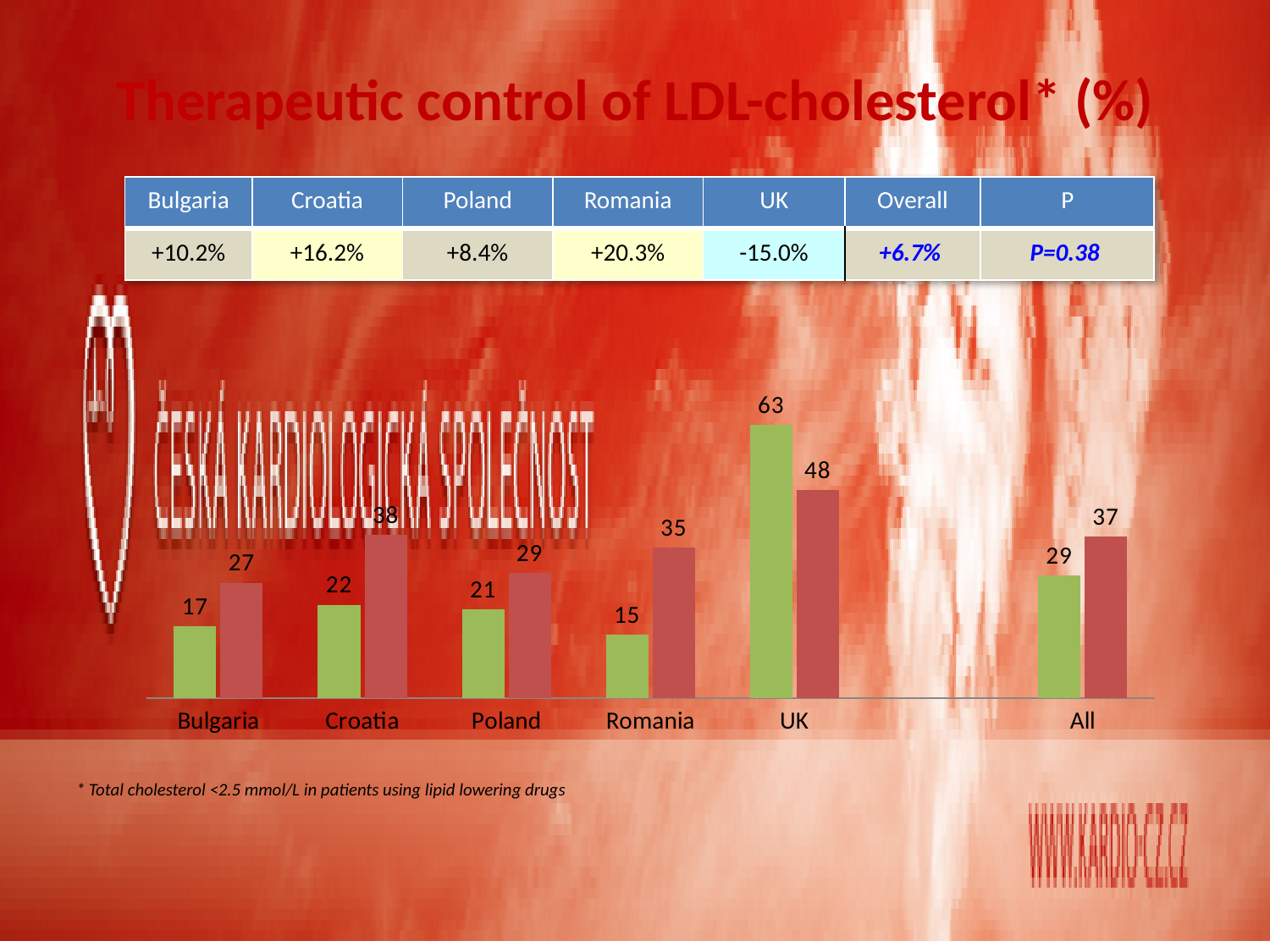
What is the value of the red bar for All? 37 Which category has the highest green bar? UK Which category has the lowest green bar? Romania Which is larger for Poland, the green bar or the red bar? the red bar What is the value of the green bar for Bulgaria? 17 Which category has the lowest red bar? Bulgaria What is the value of the green bar for the UK? 63 What is the difference between the green and red bars for Romania? 20 How many categories are shown on the x axis of the chart? 6 What is the value of the red bar for Croatia? 38 What kind of chart is shown on the slide? bar chart What is the difference between the green and red bars for the UK? 15